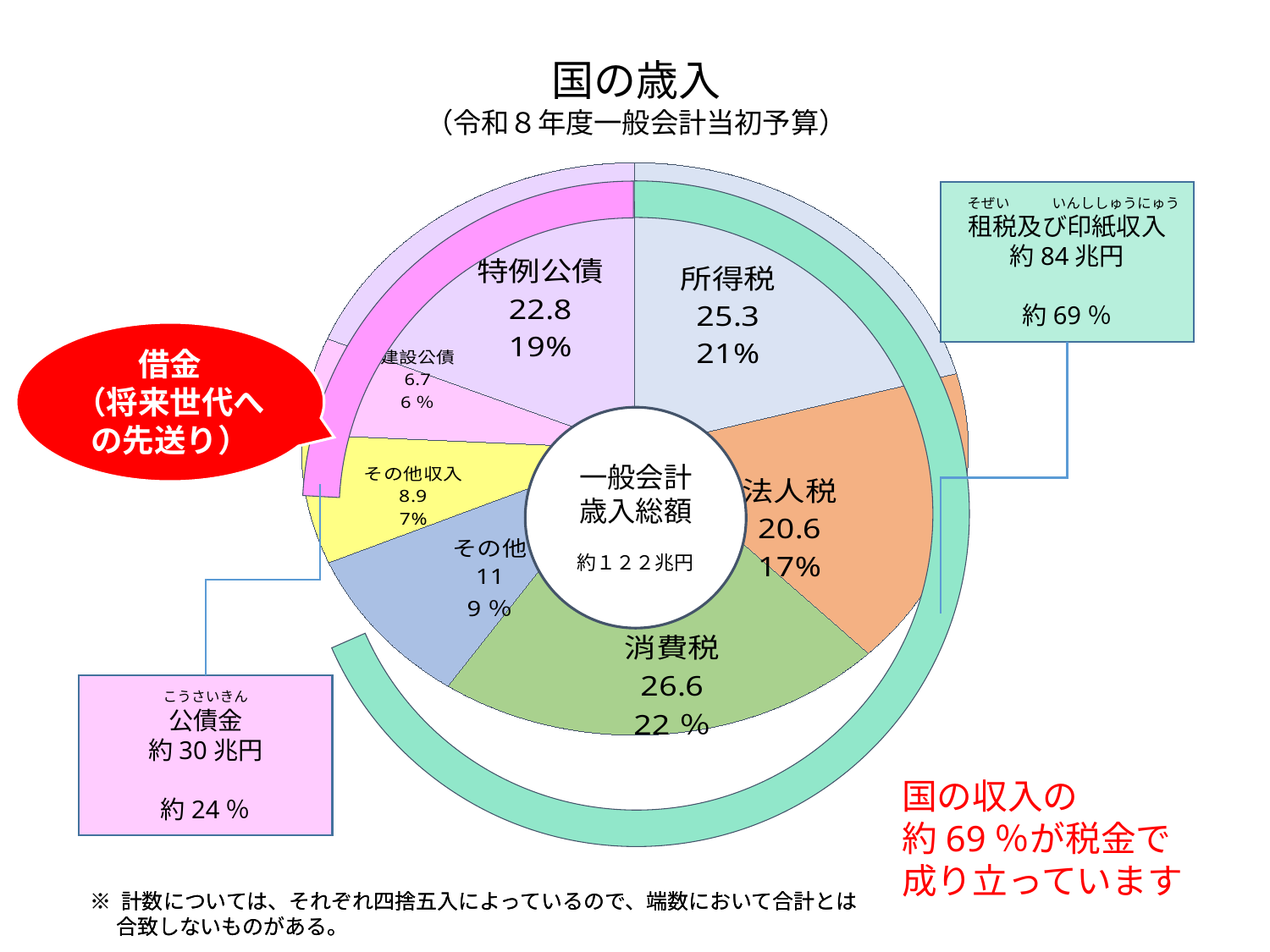
Which slice of the pie chart has the largest value? 消費税 What percentage share does 特例公債 have in the pie chart? 19% What kind of chart is shown on the slide? pie chart Which is larger, the value for 特例公債 or the value for 法人税? 特例公債 What is the value shown for 法人税 in the pie chart? 20.6 What is the difference between the values for 所得税 and 法人税? 4.7 What percentage share does 消費税 have in the pie chart? 22% What is the value shown for 所得税 in the pie chart? 25.3 Which slice of the pie chart has the smallest value? 建設公債 What total amount is shown in the centre of the pie chart for 一般会計歳入総額? 約１２２兆円 How many slices does the pie chart have? 7 What is the title of the chart on the slide? 国の歳入